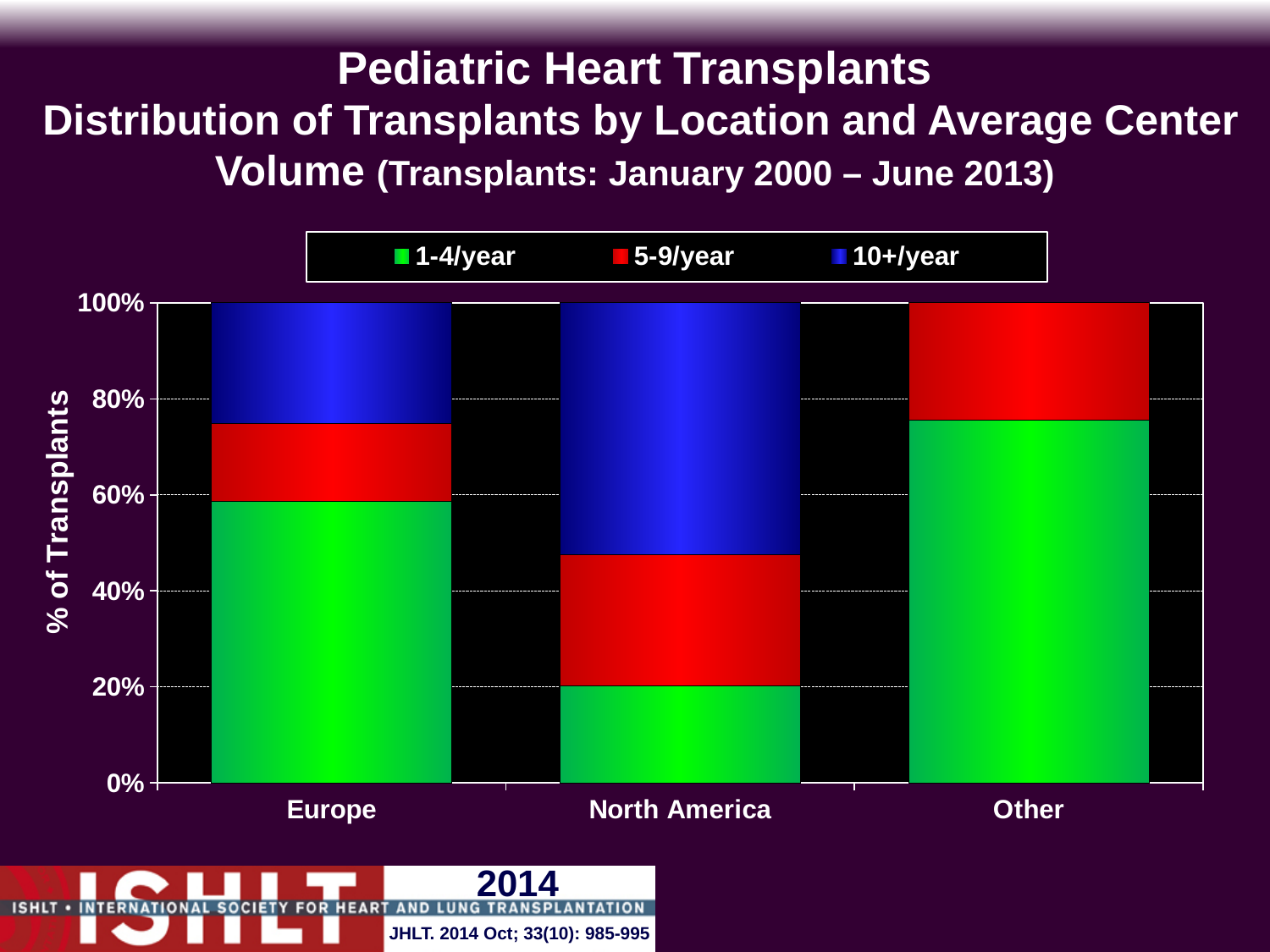
How many series does the legend list? 3 Is the 10+/year share for North America greater or less than 40%? greater How many location categories are shown on the x axis? 3 What does each stacked bar total? 100% Which location has the largest share of transplants from centers doing 1-4/year? Other Which is larger, the 1-4/year share for Europe or for North America? Europe Which location has the smallest share of transplants from centers doing 1-4/year? North America Which colour represents the 5-9/year series in the legend? red Is the 1-4/year share for Other greater or less than 60%? greater Which location has the largest share of transplants from centers doing 10+/year? North America Is the 1-4/year share for Europe greater or less than 40%? greater What kind of chart is shown on the slide? bar chart